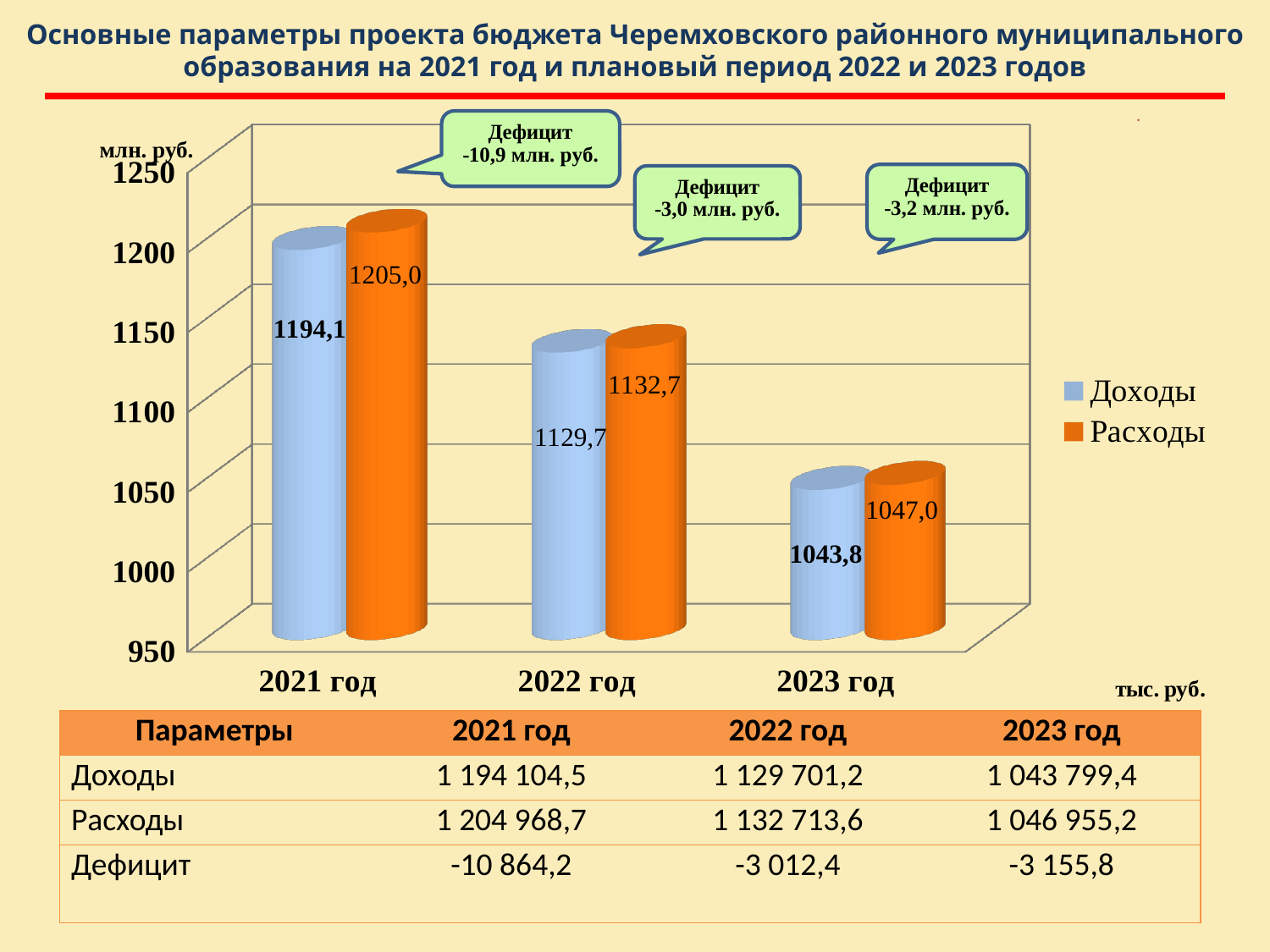
Which year has the lowest value of Доходы? 2023 год What is the value of Доходы for 2021 год? 1194,1 What is the value of Расходы for 2023 год? 1047,0 What is the difference between Расходы and Доходы for 2021 год? 10,9 What is the value of Расходы for 2021 год? 1205,0 How many series does the legend list? 2 What is the value of Доходы for 2022 год? 1129,7 What is the difference between Расходы and Доходы for 2023 год? 3,2 Do the values of Доходы rise or fall from 2021 год to 2023 год? Fall What kind of chart is shown on the slide? Bar chart Which year has the highest value of Расходы? 2021 год Which is larger for 2022 год: Доходы or Расходы? Расходы